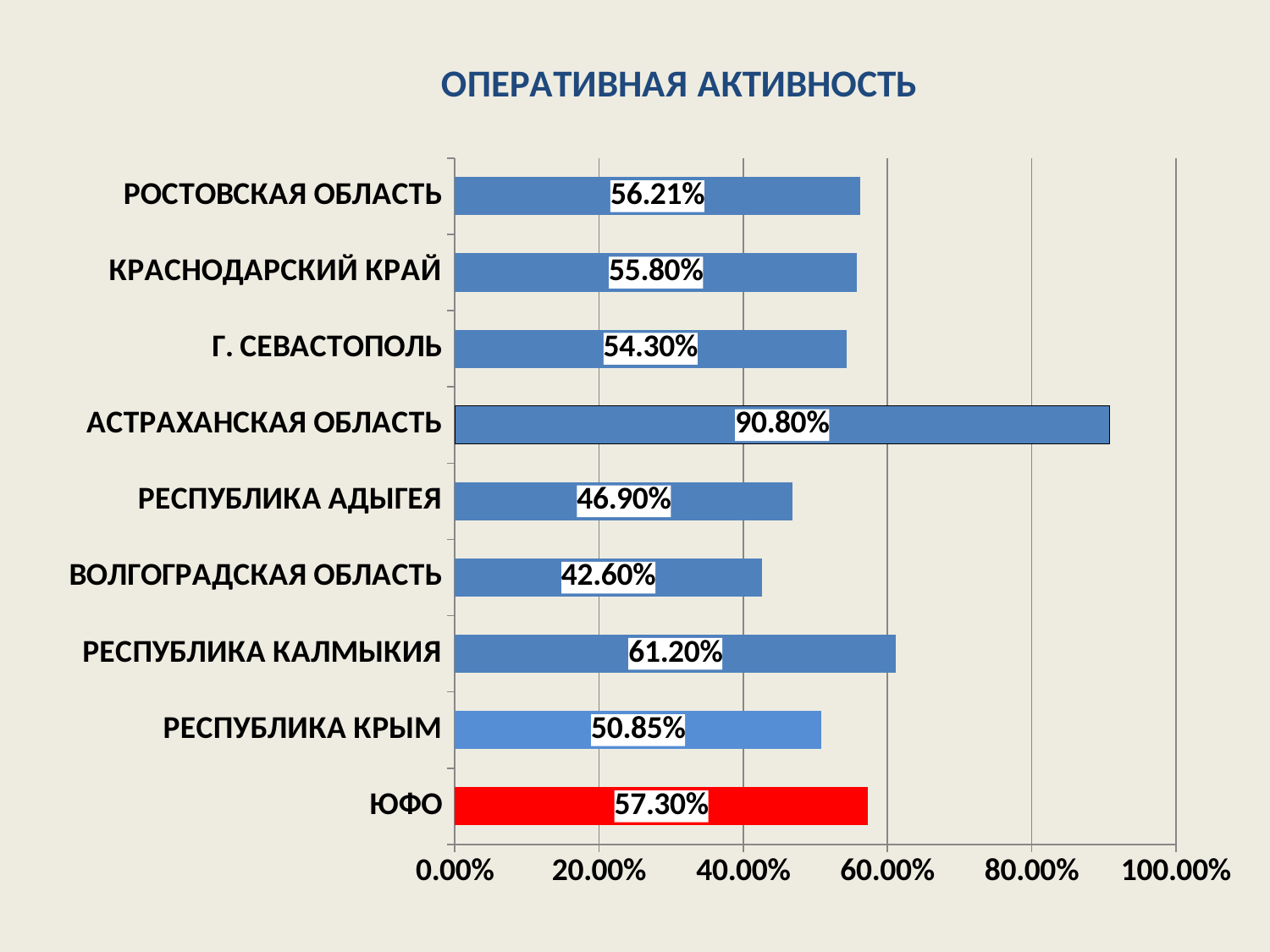
What is the value for РЕСПУБЛИКА КРЫМ? 50.85% What kind of chart is shown on the slide? bar chart Which category's bar is coloured red? ЮФО Is the value for ВОЛГОГРАДСКАЯ ОБЛАСТЬ greater or less than 60.00%? less Which category has the lowest value? ВОЛГОГРАДСКАЯ ОБЛАСТЬ What is the title of the chart? ОПЕРАТИВНАЯ АКТИВНОСТЬ Which is larger, the value for РОСТОВСКАЯ ОБЛАСТЬ or the value for Г. СЕВАСТОПОЛЬ? РОСТОВСКАЯ ОБЛАСТЬ What is the value for АСТРАХАНСКАЯ ОБЛАСТЬ? 90.80% Which category has the highest value? АСТРАХАНСКАЯ ОБЛАСТЬ What is the value for ЮФО? 57.30% What is the difference between the values for РЕСПУБЛИКА КАЛМЫКИЯ and РЕСПУБЛИКА АДЫГЕЯ? 14.30% How many categories are shown in the chart? 9